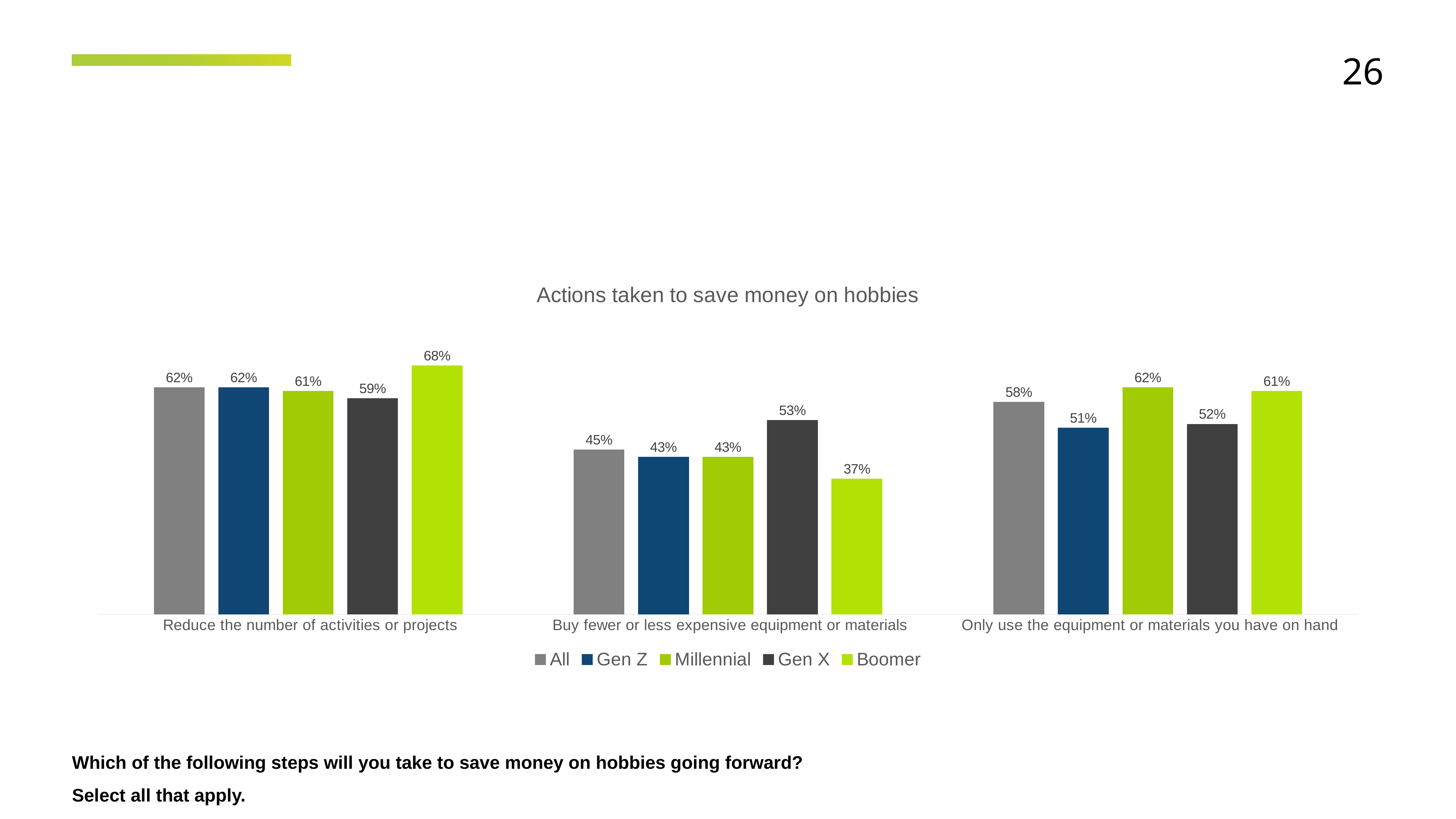
Which series has the highest value in the 'Reduce the number of activities or projects' category? Boomer What is the value for Gen X in the 'Buy fewer or less expensive equipment or materials' category? 53% What kind of chart is shown on the slide? Bar chart What is the difference between the Gen X and Boomer values in the 'Buy fewer or less expensive equipment or materials' category? 16% What is the value for All in the 'Only use the equipment or materials you have on hand' category? 58% In the 'Only use the equipment or materials you have on hand' category, which is larger: the Millennial value or the Gen Z value? Millennial Which series has the lowest value in the 'Buy fewer or less expensive equipment or materials' category? Boomer How many series does the legend list? 5 What is the title of the chart? Actions taken to save money on hobbies What is the value for Boomer in the 'Reduce the number of activities or projects' category? 68% What is the difference between the Boomer values for 'Reduce the number of activities or projects' and 'Buy fewer or less expensive equipment or materials'? 31% How many categories are shown on the x axis? 3